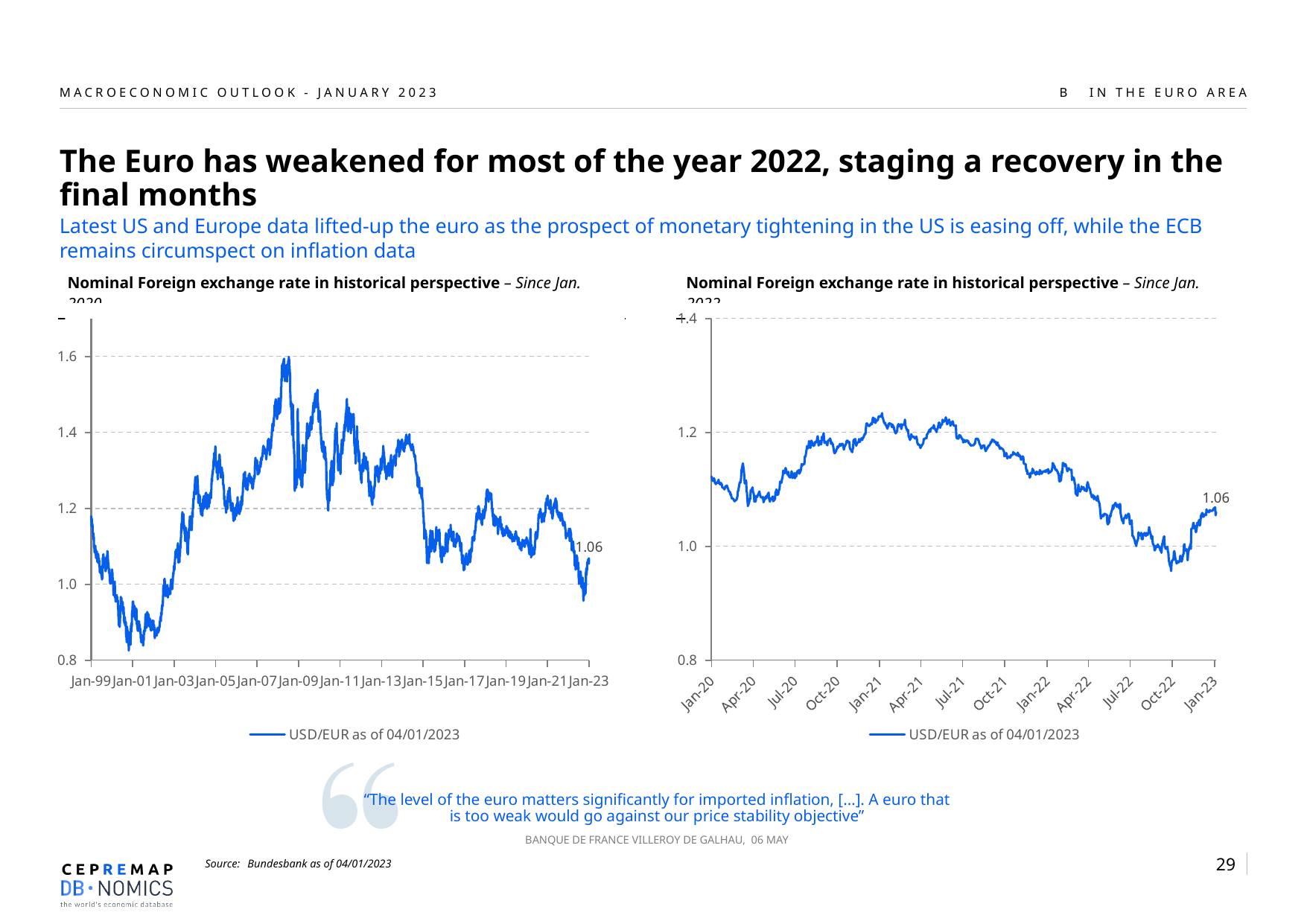
What kind of chart is the left chart, 'Nominal Foreign exchange rate in historical perspective' starting Jan-99? line chart On the left chart (starting Jan-99), what value is printed as a data label at the end of the line near Jan-23? 1.06 On the right chart, is the USD/EUR value at Jan-20 greater or less than 1.0? greater What is the legend entry shown below the left chart? USD/EUR as of 04/01/2023 What is the highest value shown on the y axis of the left chart? 1.6 On the left chart, is the USD/EUR value around Jan-01 greater or less than 1.0? less How many date labels are shown on the x axis of the right chart? 13 How many series does the legend of the right chart list? 1 On the right chart, does the USD/EUR line generally rise or fall between Jul-21 and Oct-22? fall On the left chart, is the USD/EUR value around Jan-09 greater or less than 1.2? greater On the right chart (starting Jan-20), what is the latest USD/EUR value printed as a data label at the end of the line? 1.06